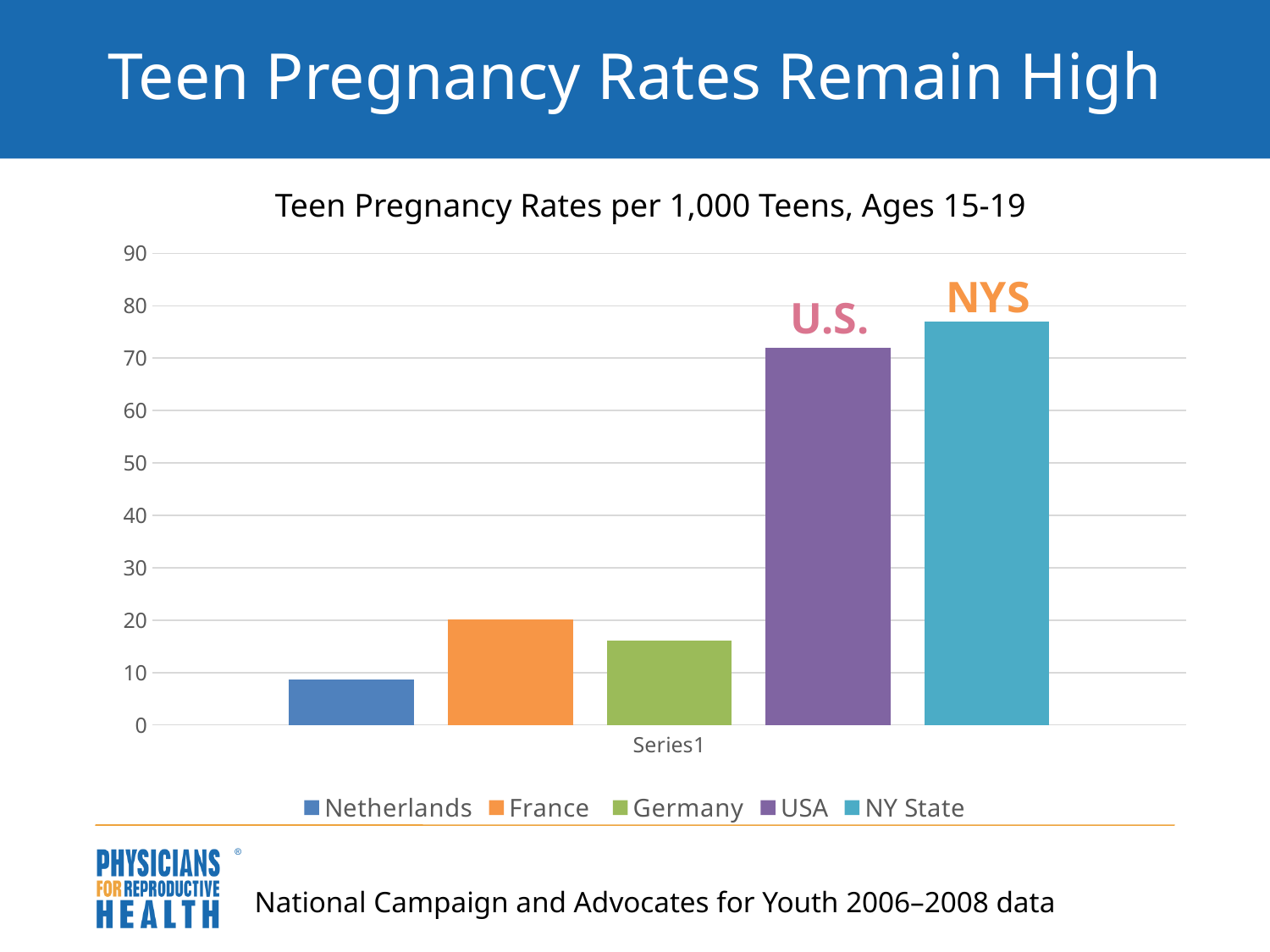
How many bars are plotted in the chart? 5 What kind of chart is shown on the slide? bar chart Which is larger, the value for France or the value for Germany? France Is the value for USA greater or less than 60? greater Which series has the lowest teen pregnancy rate? Netherlands Is the value for NY State greater or less than 80? less What is the title of the chart? Teen Pregnancy Rates per 1,000 Teens, Ages 15-19 Which is larger, the value for USA or the value for NY State? NY State Which is larger, the value for Netherlands or the value for Germany? Germany Is the value for Germany greater or less than 20? less How many series does the legend list? 5 Which series has the highest teen pregnancy rate? NY State